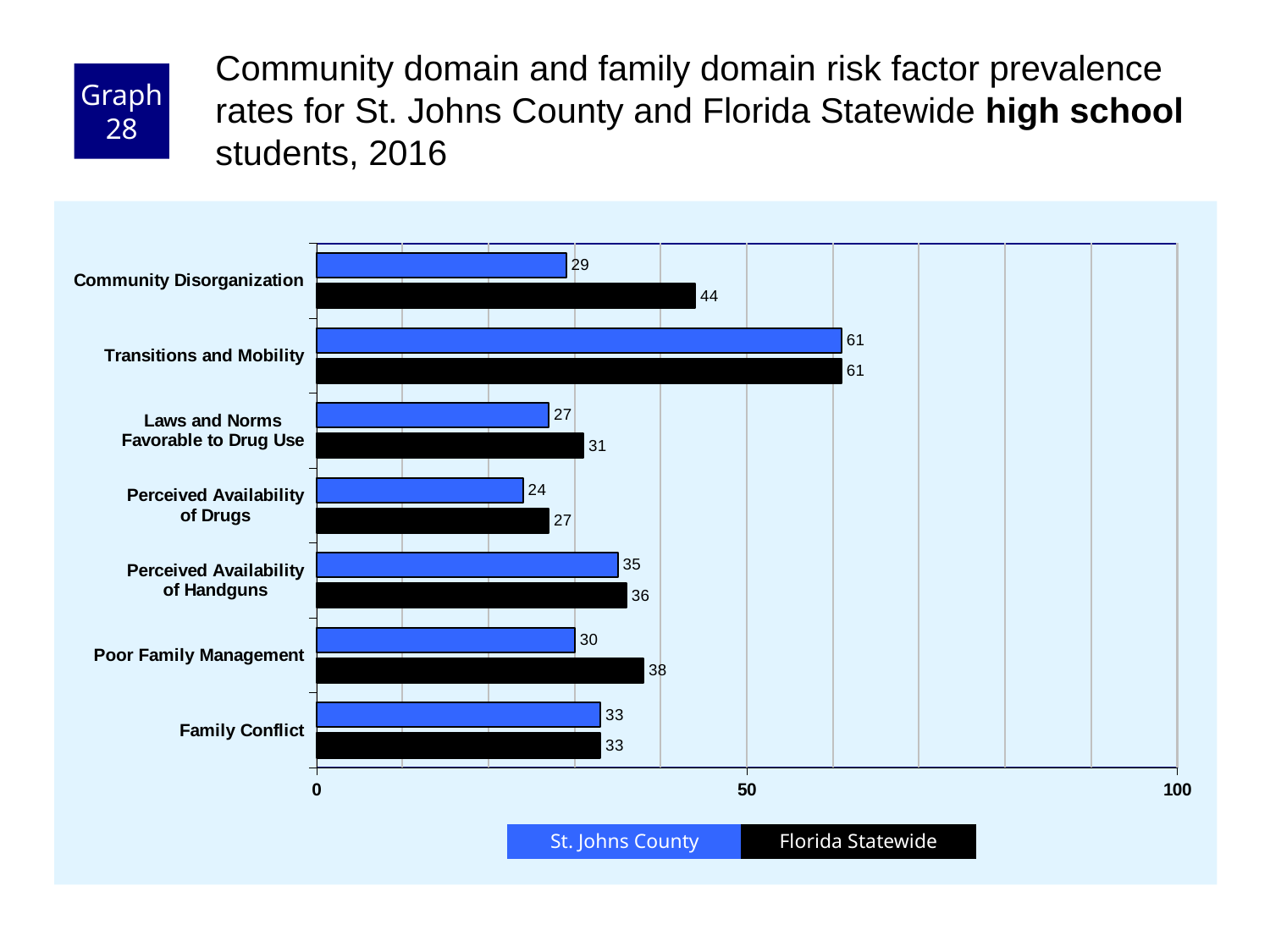
Which is larger for Poor Family Management: the St. Johns County value or the Florida Statewide value? Florida Statewide Which risk factor has the lowest Florida Statewide value? Perceived Availability of Drugs What is the St. Johns County value for Community Disorganization? 29 What is the difference between the Florida Statewide and St. Johns County values for Community Disorganization? 15 What kind of chart is shown on the slide? bar chart Is the Florida Statewide value for Transitions and Mobility greater or less than 50? greater Which risk factor has the highest St. Johns County value? Transitions and Mobility How many series does the legend list? 2 Which colour represents Florida Statewide in the chart? black What is the St. Johns County value for Perceived Availability of Drugs? 24 What is the Florida Statewide value for Poor Family Management? 38 How many risk factors are shown on the chart? 7